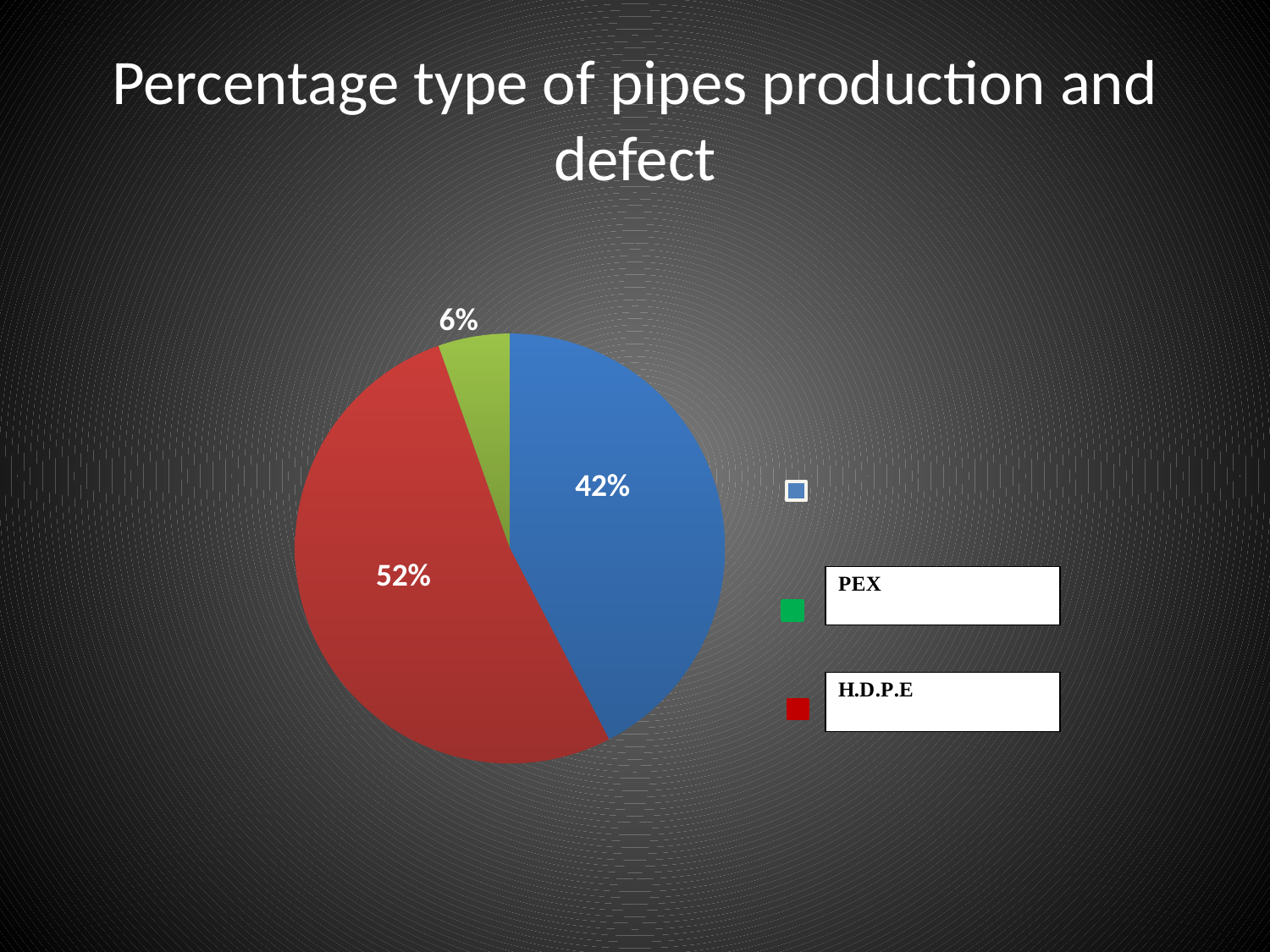
Which is larger, the share for H.D.P.E or the share for PEX? H.D.P.E Which category has the smallest slice of the pie? PEX What colour is the H.D.P.E slice in the pie chart? red What percentage is shown on the blue slice of the pie? 42% What share of the pie does H.D.P.E represent? 52% Which labelled category has the largest slice of the pie? H.D.P.E How many slices does the pie chart have? 3 What is the title of the chart? Percentage type of pipes production and defect What is the difference between the red slice (52%) and the blue slice (42%)? 10% What share of the pie does PEX represent? 6% What is the difference between the H.D.P.E share and the PEX share? 46% What type of chart is shown on the slide? pie chart